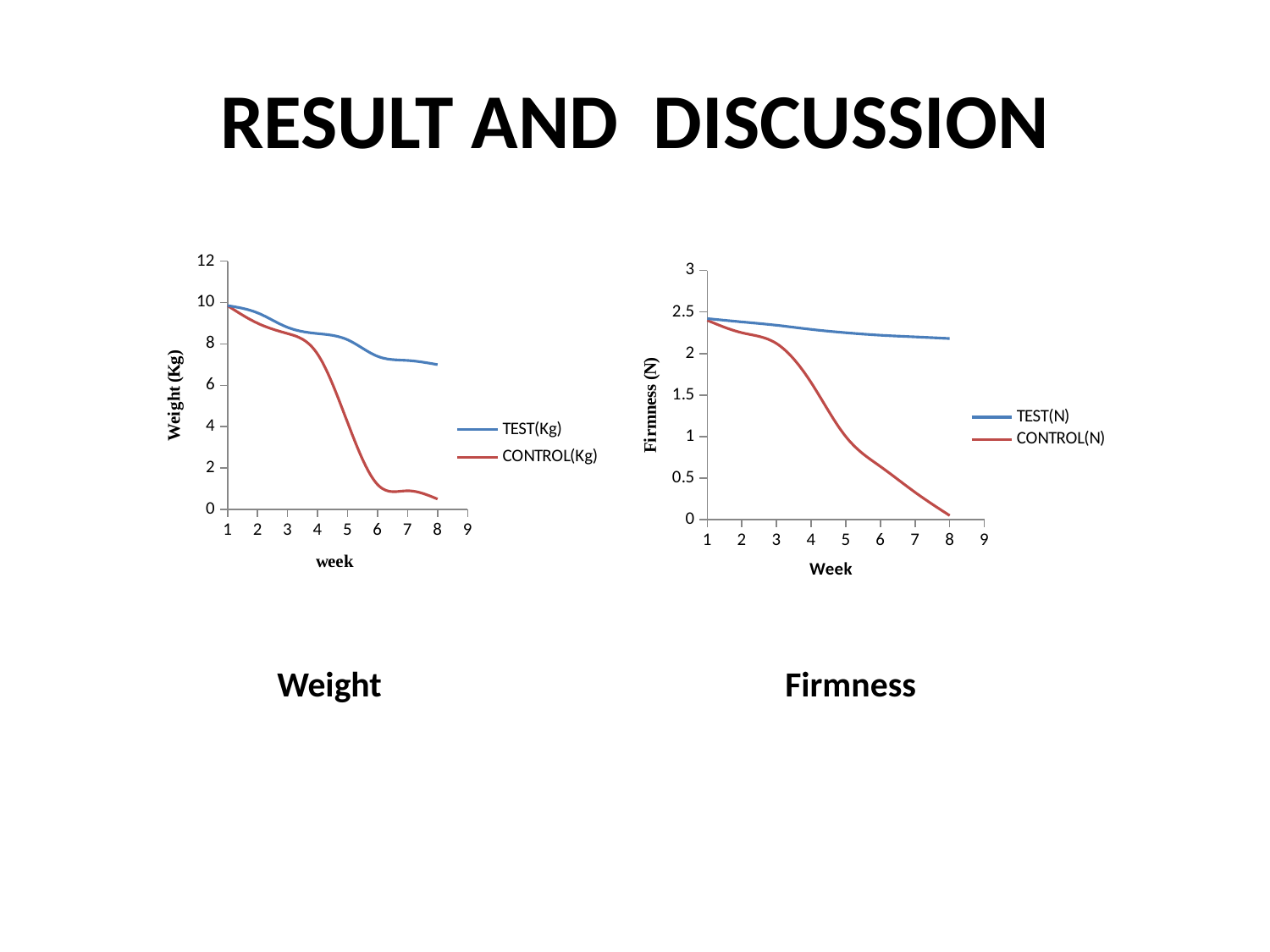
What kind of chart is the Weight chart on the left? line chart How many series does the legend of the Weight chart list? 2 What is the y-axis title of the Firmness chart? Firmness (N) In the Firmness chart, is the value for TEST(N) at week 8 greater or less than 2? greater In the Weight chart, which series has the higher value at week 6, TEST(Kg) or CONTROL(Kg)? TEST(Kg) In the Weight chart, does the CONTROL(Kg) line rise or fall from week 1 to week 8? fall In the Weight chart, is the value for CONTROL(Kg) at week 6 greater or less than 2? less How many series does the legend of the Firmness chart list? 2 In the Firmness chart, does the TEST(N) line rise or fall from week 1 to week 8? fall In the Firmness chart, is the value for CONTROL(N) at week 8 greater or less than 0.5? less What kind of chart is the Firmness chart on the right? line chart